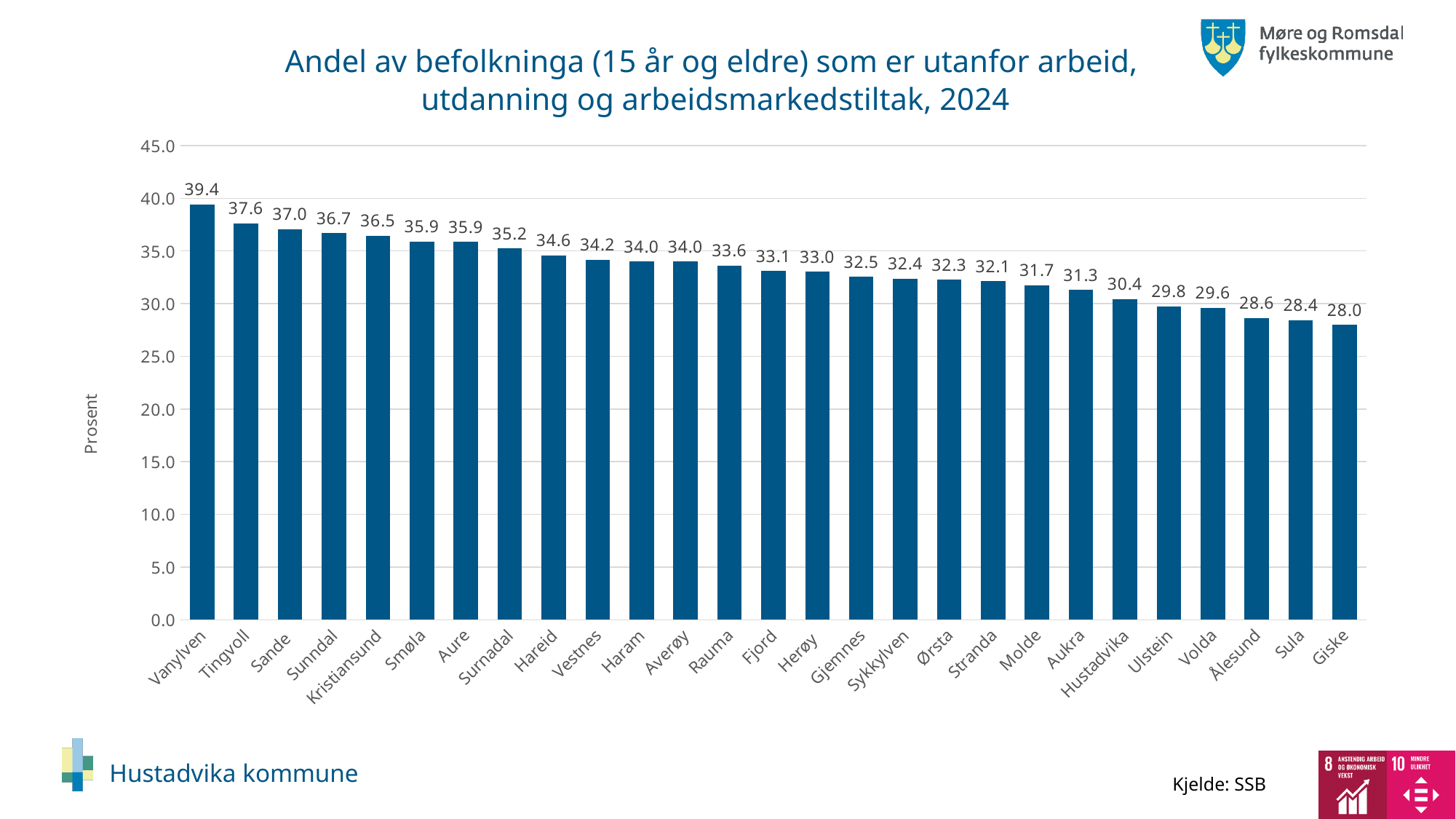
What is the difference between the values for Vanylven and Giske? 11.4 Which has a larger value, Tingvoll or Sula? Tingvoll What is the value for Molde? 31.7 Do the values rise or fall from left to right along the x axis? fall What is the difference between the values for Hustadvika and Ålesund? 1.8 What kind of chart is shown on the slide? bar chart How many municipalities are shown on the chart? 27 What is the value for Kristiansund? 36.5 What is the value for Hustadvika? 30.4 Which municipality has the highest value? Vanylven Is the value for Ulstein greater or less than 30.0? less Which municipality has the lowest value? Giske